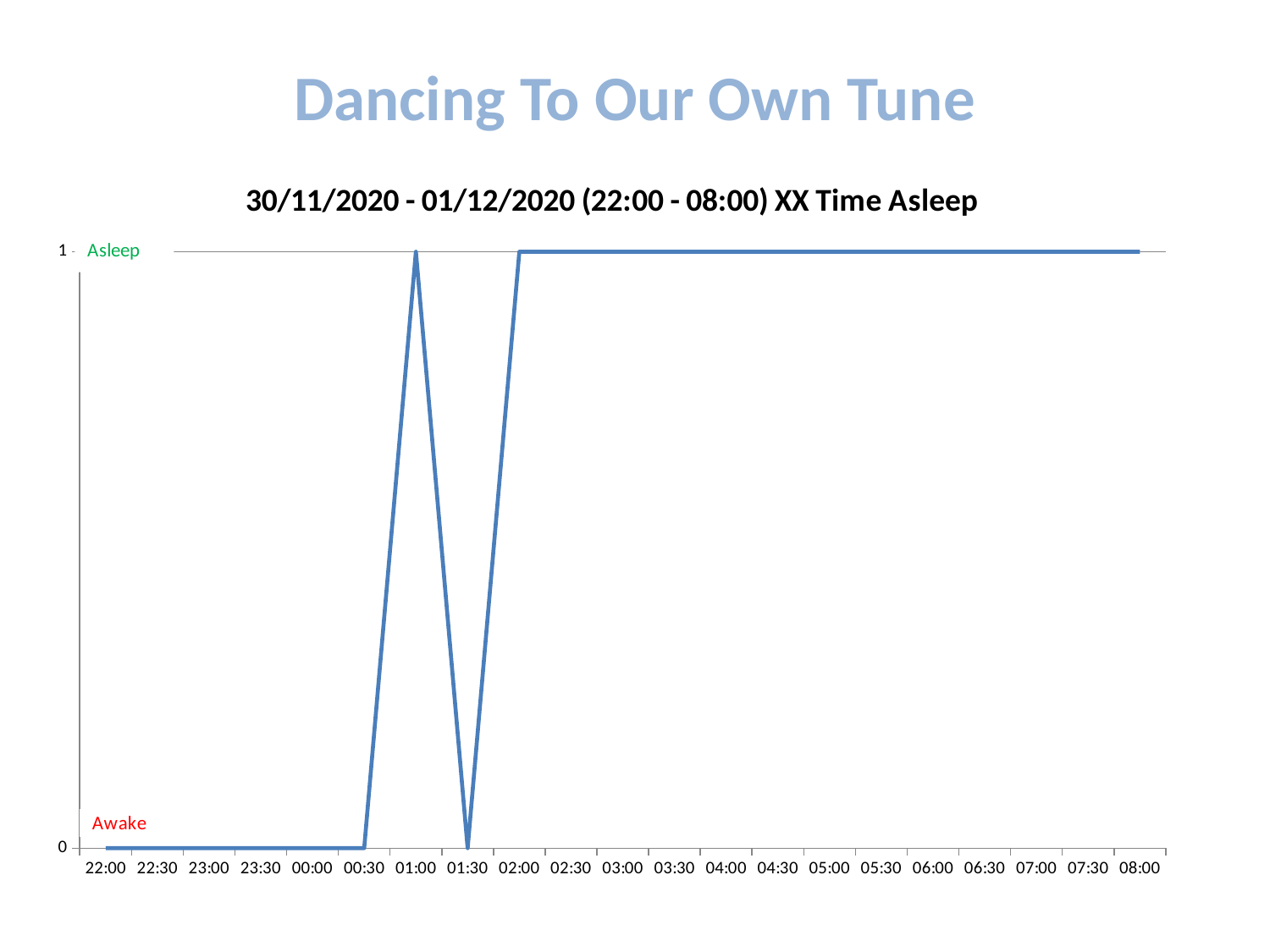
What is the value of the line at 22:00? 0 What is the value of the line at 01:00? 1 What is the value of the line at 05:00? 1 What kind of chart is shown on the slide? Line chart How many time points are labelled on the x axis? 21 Which label is shown next to the y-axis value 1? Asleep What is the difference between the value at 01:00 and the value at 01:30? 1 What is the value of the line at 00:30? 0 What is the value of the line at 01:30? 0 What is the title of the chart? 30/11/2020 - 01/12/2020 (22:00 - 08:00) XX Time Asleep Does the line rise or fall between 01:00 and 01:30? fall Is the value at 02:00 larger or smaller than the value at 01:30? larger